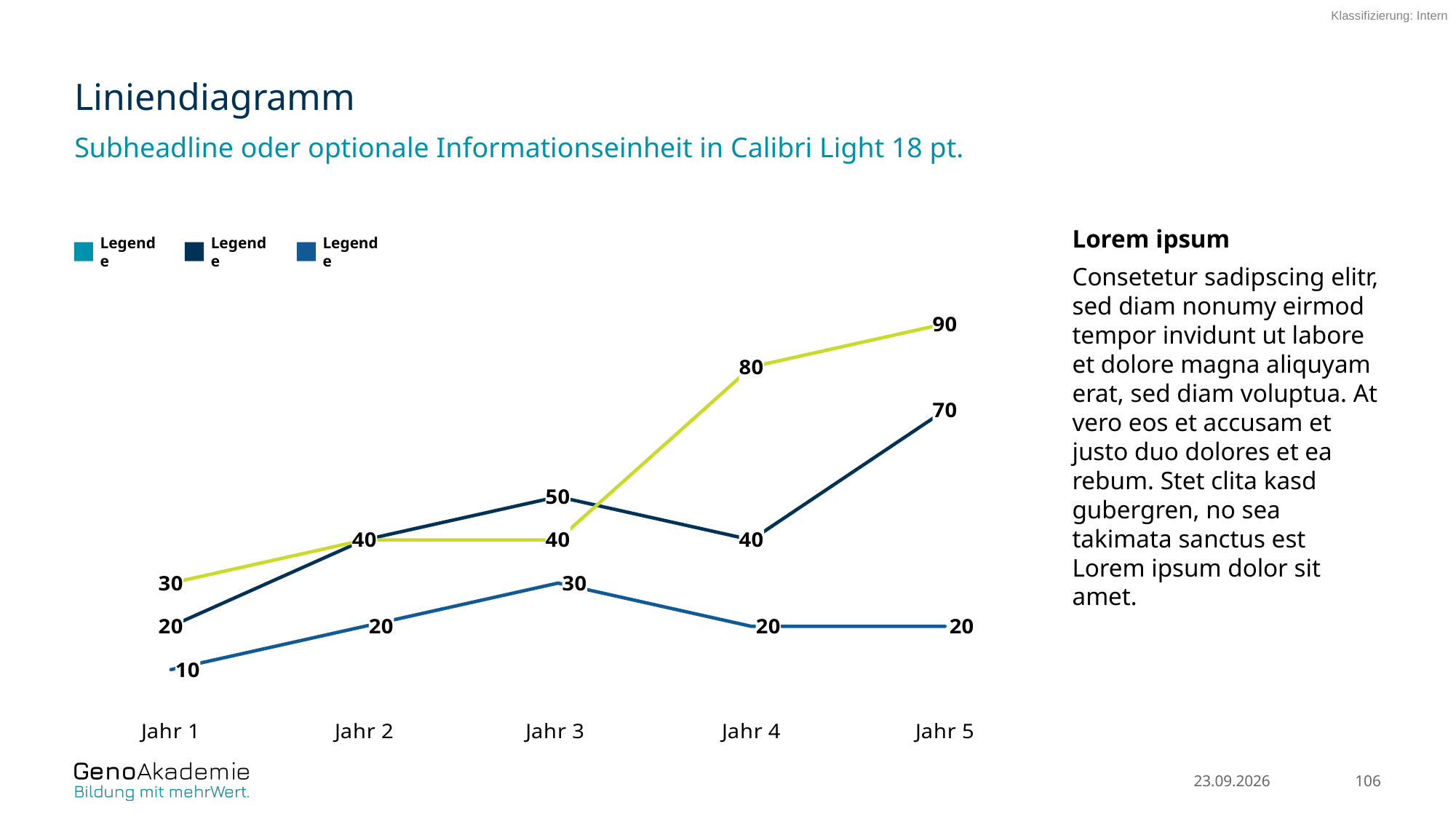
Does the yellow-green line rise or fall from Jahr 3 to Jahr 5? rise What is the value of the lighter blue line at Jahr 1? 10 What is the value of the yellow-green line at Jahr 5? 90 How many categories are shown on the x axis of the chart? 5 What is the title of the slide containing the chart? Liniendiagramm How many series does the chart's legend list? 3 At which year does the dark navy line have its lowest value? Jahr 1 By how much does the yellow-green line increase from Jahr 4 to Jahr 5? 10 At which year does the yellow-green line reach its highest value? Jahr 5 At Jahr 4, which line has the larger value, the yellow-green line or the dark navy line? the yellow-green line What is the value of the dark navy line at Jahr 3? 50 What kind of chart is shown on the slide? line chart